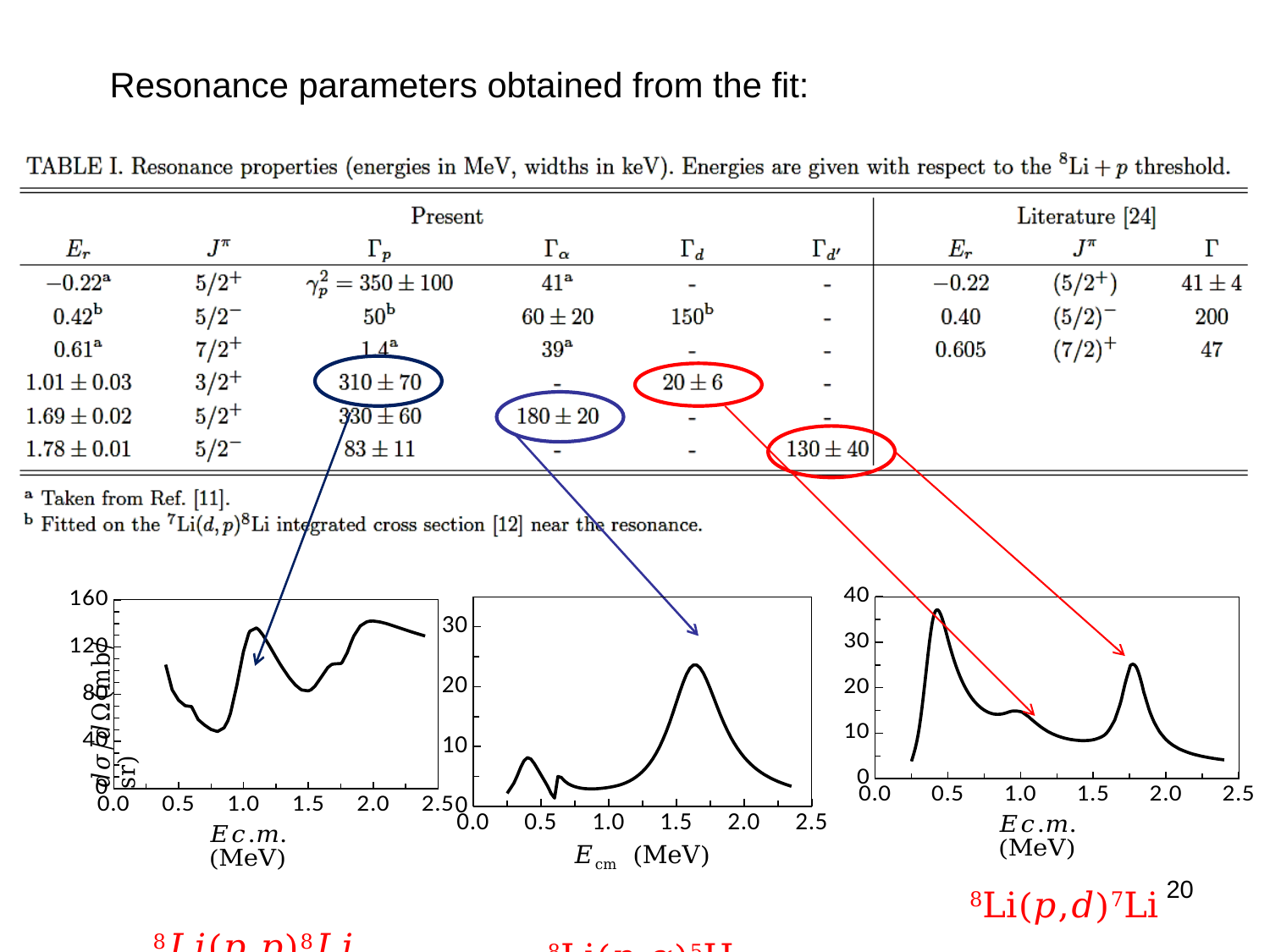
In the middle chart, is the value at the peak near 1.65 MeV greater or less than 20? greater What is the x-axis label of the right-hand chart (8Li(p,d)7Li)? E c.m. (MeV) In the right-hand chart (8Li(p,d)7Li), which peak is higher: the one near 0.45 MeV or the one near 1.8 MeV? the one near 0.45 MeV In the left-hand chart, is the value at the dip near 0.8 MeV greater or less than 80? less How many charts are shown at the bottom of the slide? 3 In the left-hand chart, is the value at the peak near 1.1 MeV greater or less than 120? greater What is the highest value shown on the y axis of the left-hand chart? 160 What kind of chart is the left-hand chart at the bottom of the slide? line chart